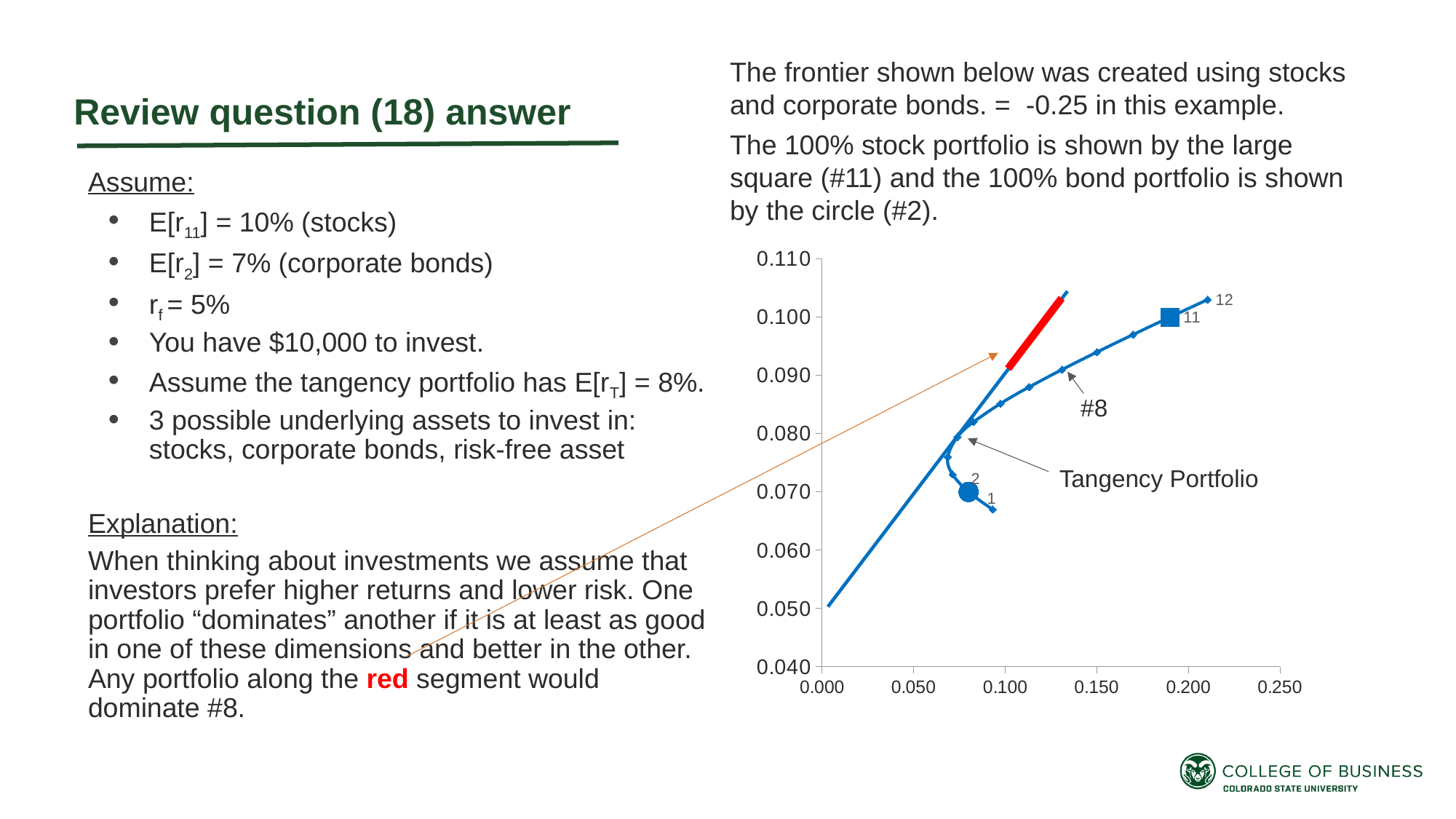
Is the x-axis value of the large square (point 11) greater or less than 0.150? greater What kind of chart is shown on the slide? line chart (scatter with connected points) Is the y-axis value of point 12 greater or less than 0.100? greater Which has the higher y-axis value, point 11 or point 12? point 12 What is the y-axis value of the large circle labeled 2? 0.070 Is the y-axis value of point 1 greater or less than 0.070? less Moving from point 2 toward point 12 along the frontier, do the y-axis values rise or fall? rise What is the y-axis value of the large square labeled 11? 0.100 Which portfolio does the large square on the chart represent? the 100% stock portfolio (#11) Which of the labeled points has the lowest y-axis value? point 1